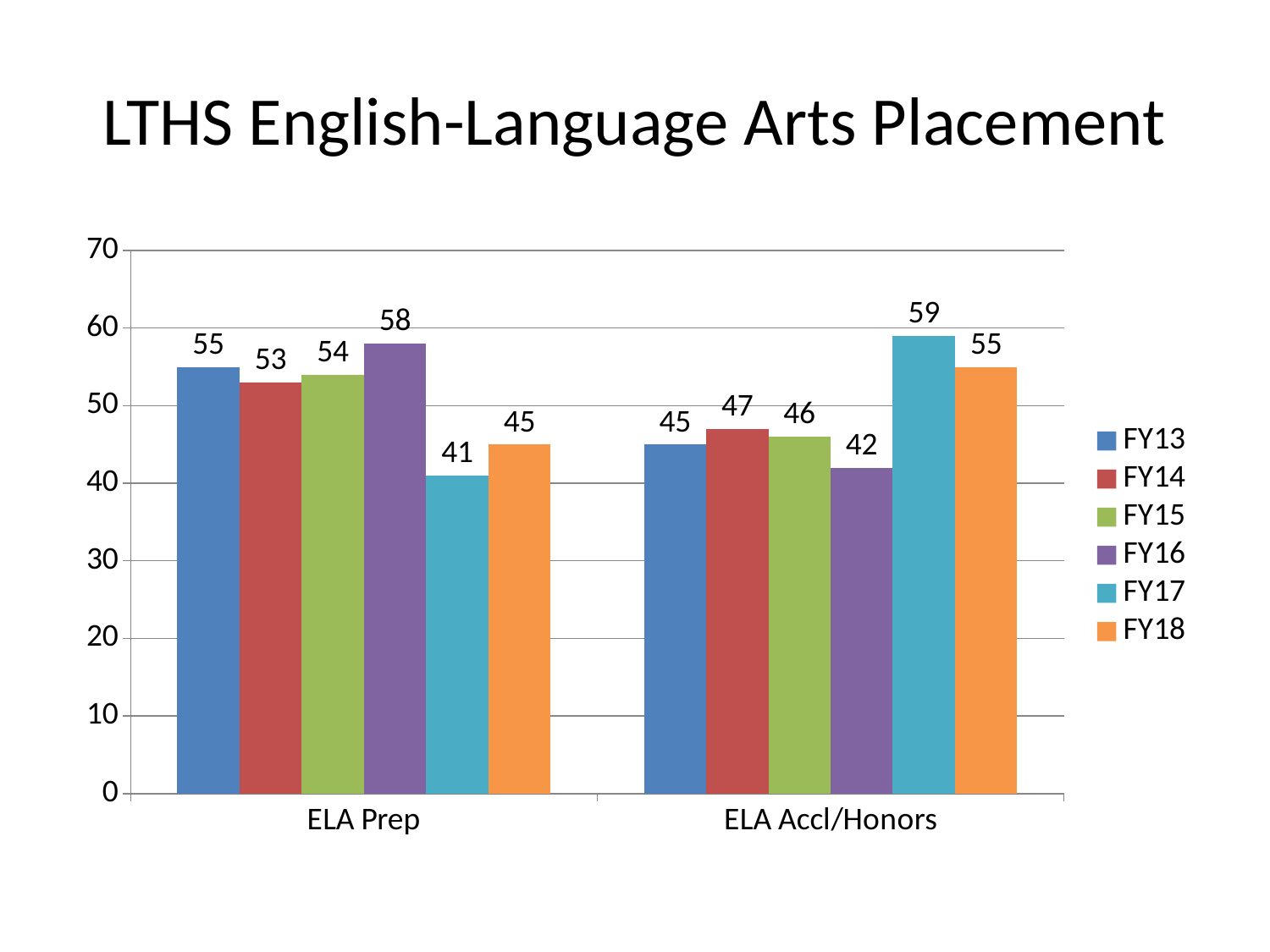
How many series does the legend list? 6 How many categories are shown on the x axis? 2 What kind of chart is shown on the slide? bar chart What is the difference between the FY17 values for ELA Accl/Honors and ELA Prep? 18 Which is larger: the FY18 value for ELA Prep or the FY18 value for ELA Accl/Honors? ELA Accl/Honors Is the FY17 value for ELA Prep greater or less than 50? less Which series has the lowest value in the ELA Accl/Honors category? FY16 What is the value for FY17 in the ELA Accl/Honors category? 59 What is the value for FY16 in the ELA Prep category? 58 What is the value for FY13 in the ELA Accl/Honors category? 45 What is the title of the slide? LTHS English-Language Arts Placement Which series has the highest value in the ELA Prep category? FY16